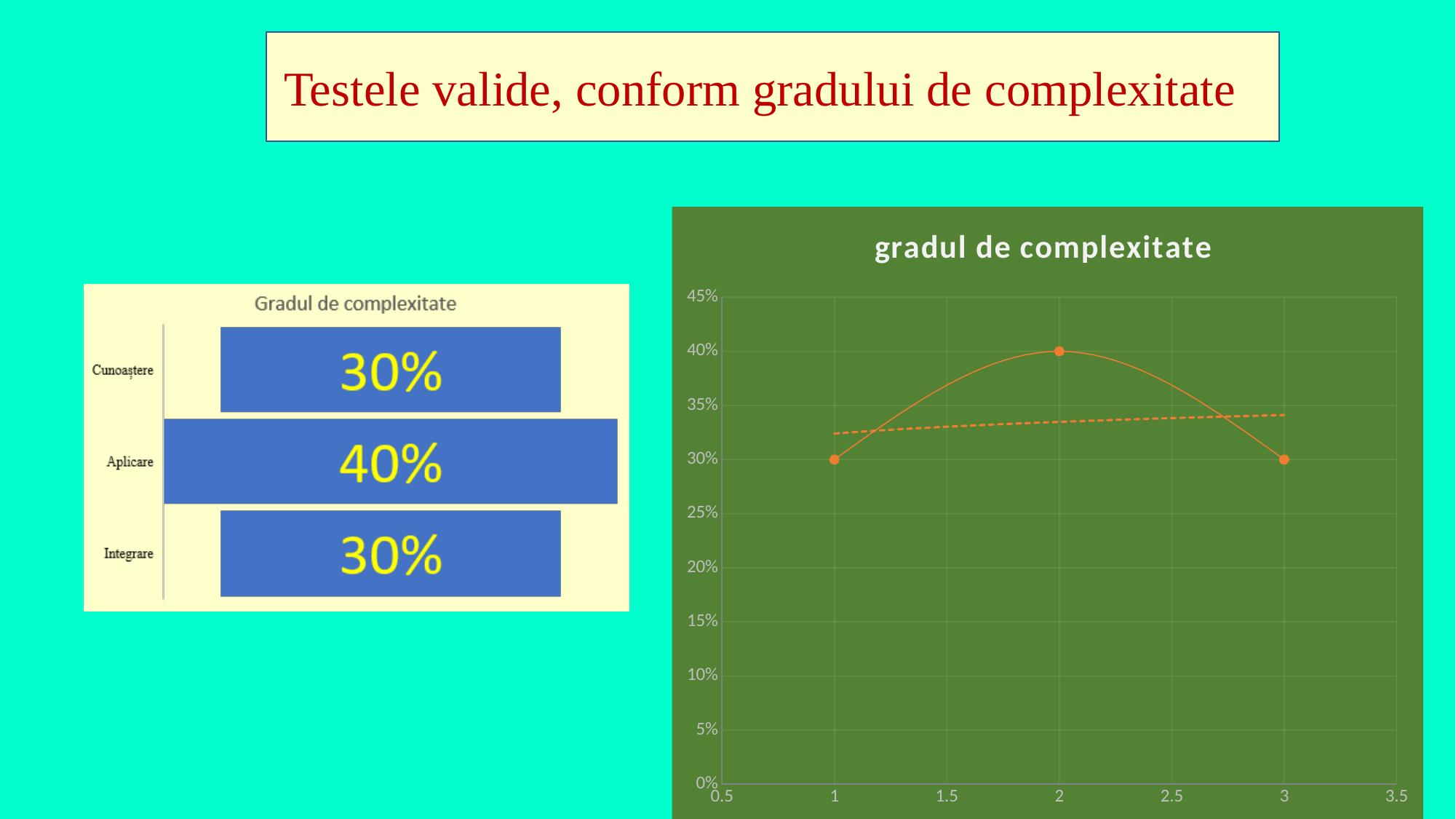
In the right chart titled 'gradul de complexitate', what is the value of the point at x = 2? 40% In the right chart titled 'gradul de complexitate', is the value of the point at x = 1 greater or less than 35%? less In the left chart titled 'Gradul de complexitate', what is the value for Cunoaștere? 30% In the left chart titled 'Gradul de complexitate', what is the value for Integrare? 30% In the left chart titled 'Gradul de complexitate', what is the difference between the values for Aplicare and Cunoaștere? 10% In the right chart titled 'gradul de complexitate', how many data points are plotted? 3 What kind of chart is the left chart titled 'Gradul de complexitate'? bar chart In the right chart titled 'gradul de complexitate', what is the value of the point at x = 3? 30% In the left chart titled 'Gradul de complexitate', what is the value for Aplicare? 40% In the left chart titled 'Gradul de complexitate', how many categories are shown? 3 In the left chart titled 'Gradul de complexitate', which category has the highest value? Aplicare In the left chart titled 'Gradul de complexitate', which is larger, the value for Aplicare or the value for Integrare? Aplicare